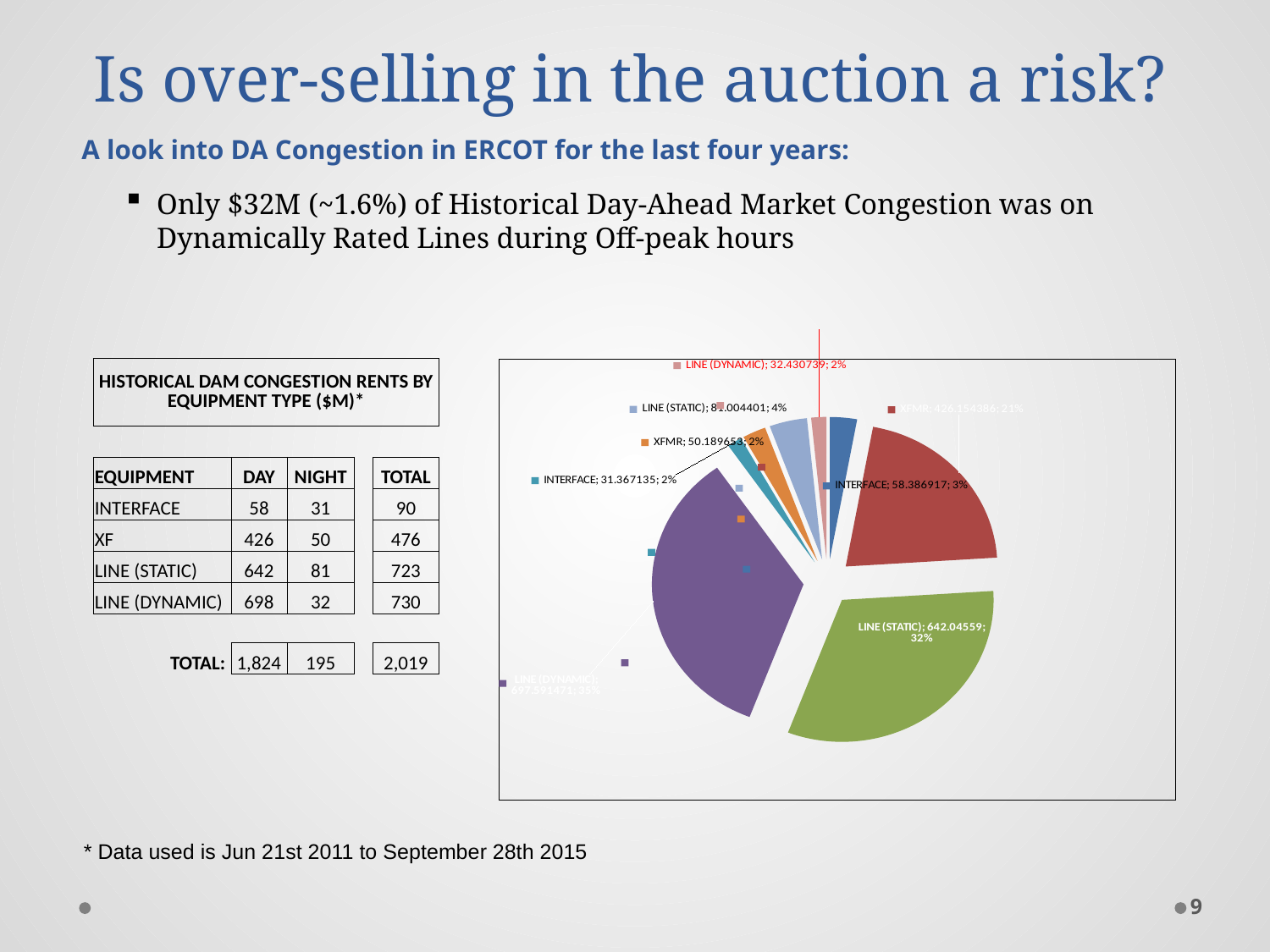
What colour is the text of the data label reading 'LINE (DYNAMIC); 32.430739; 2%'? Red What value is printed for the INTERFACE slice that makes up 2% of the pie? 31.367135 What share of the pie does the LINE (STATIC) slice labelled 642.04559 represent? 32% What share of the pie does the INTERFACE slice labelled 58.386917 represent? 3% Which is larger: the LINE (STATIC) slice labelled 642.04559 or the INTERFACE slice labelled 58.386917? LINE (STATIC) 642.04559 What kind of chart is shown on the slide? Pie chart What value is printed on the LINE (STATIC) slice that makes up 32% of the pie? 642.04559 What value is printed for the INTERFACE slice that makes up 3% of the pie? 58.386917 How many slices does the pie chart have? 8 What is the difference in share between the LINE (STATIC) slice at 32% and the INTERFACE slice at 3%? 29 percentage points What value is printed for the LINE (DYNAMIC) slice that makes up 2% of the pie? 32.430739 What colour is the LINE (STATIC) slice that makes up 32% of the pie? Green